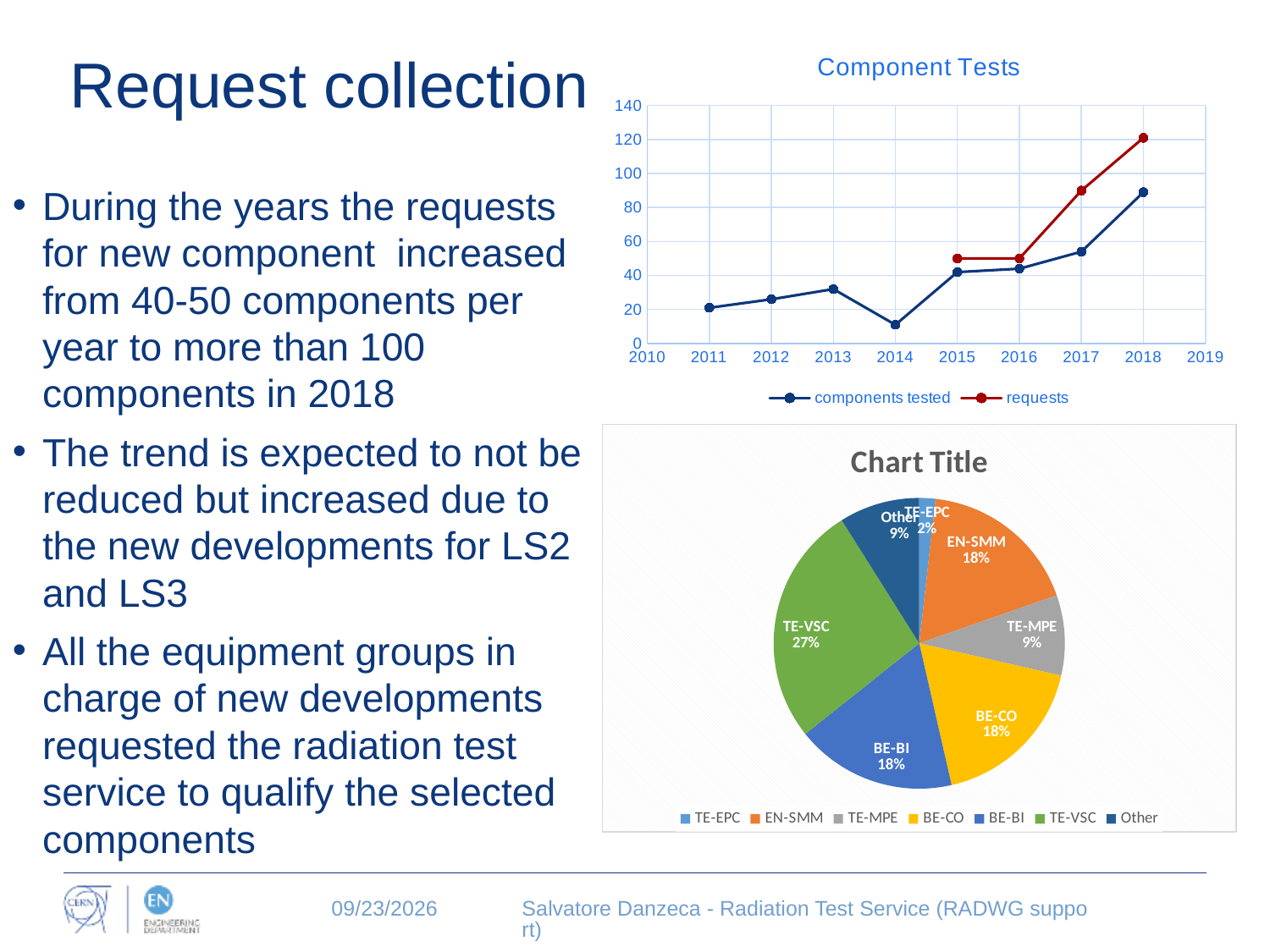
In the pie chart titled "Chart Title", what share does TE-VSC have? 27% In the "Component Tests" chart, is the value for components tested in 2014 greater or less than 20? less How many slices does the pie chart titled "Chart Title" have? 7 What kind of chart is the "Component Tests" chart? line chart In the pie chart titled "Chart Title", which group has the smallest slice? TE-EPC In the "Component Tests" chart, which series has the larger value in 2018, components tested or requests? requests In the "Component Tests" chart, do the components tested values rise or fall from 2014 to 2018? rise In the pie chart titled "Chart Title", which group has the largest slice? TE-VSC In the "Component Tests" chart, in which year is the components tested value lowest? 2014 In the pie chart titled "Chart Title", what is the value shown for BE-CO? 18% In the "Component Tests" chart, is the value for requests in 2018 greater or less than 100? greater How many series does the legend of the "Component Tests" chart list? 2